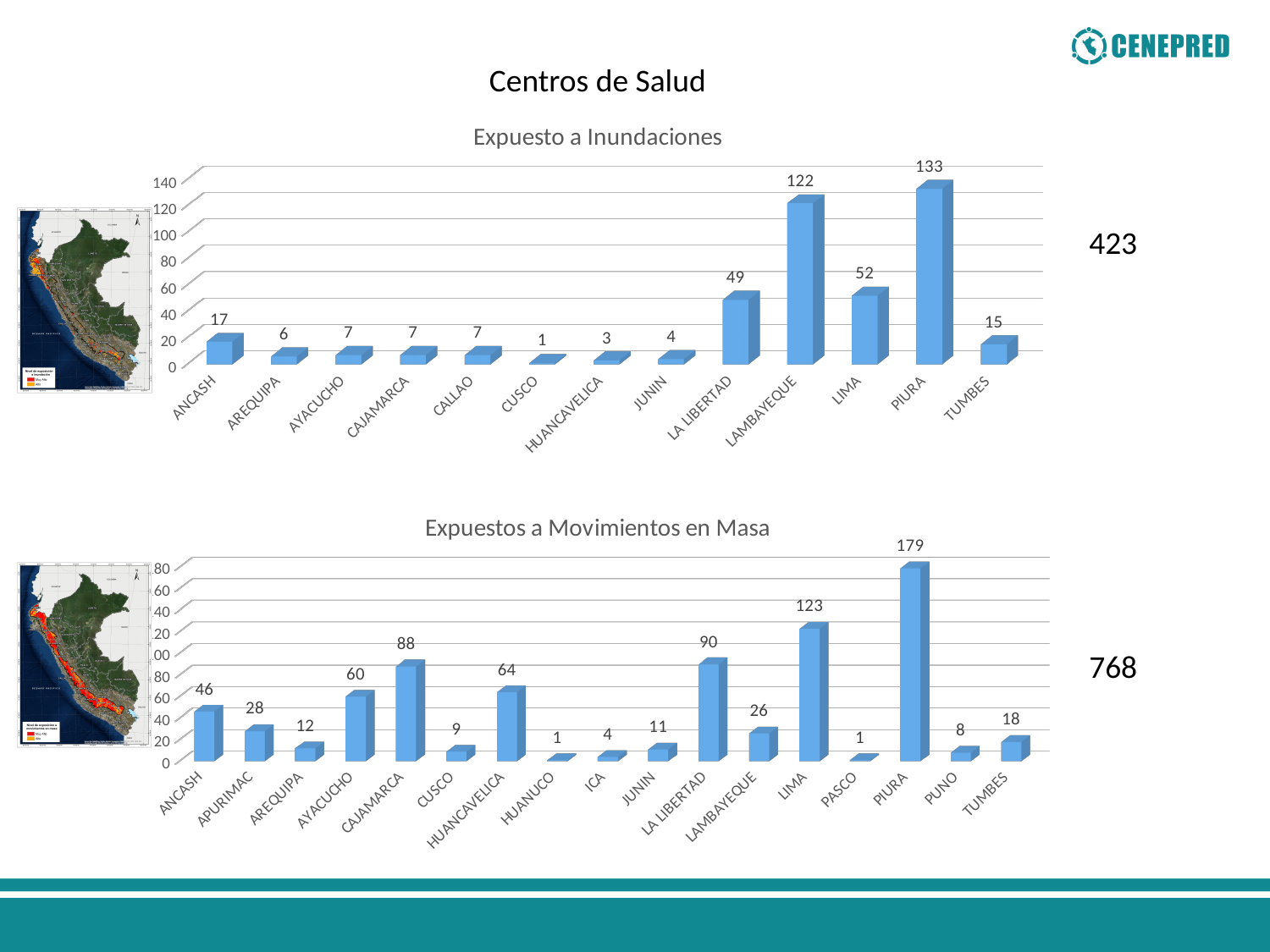
In the 'Expuesto a Inundaciones' chart, which department has the highest value? PIURA What is the title of the bottom chart on the slide? Expuestos a Movimientos en Masa In the 'Expuestos a Movimientos en Masa' chart, how many departments are shown on the x axis? 17 In the 'Expuesto a Inundaciones' chart, how many departments are shown on the x axis? 13 In the 'Expuestos a Movimientos en Masa' chart, what is the difference between the values for PIURA and LIMA? 56 In the 'Expuestos a Movimientos en Masa' chart, which department has the highest value? PIURA What kind of chart is the 'Expuesto a Inundaciones' chart? Bar chart In the 'Expuesto a Inundaciones' chart, what is the value for LAMBAYEQUE? 122 In the 'Expuestos a Movimientos en Masa' chart, which is larger, the value for LA LIBERTAD or the value for HUANCAVELICA? LA LIBERTAD In the 'Expuesto a Inundaciones' chart, what is the difference between the values for PIURA and LAMBAYEQUE? 11 In the 'Expuesto a Inundaciones' chart, which department has the lowest value? CUSCO In the 'Expuestos a Movimientos en Masa' chart, what is the value for CAJAMARCA? 88